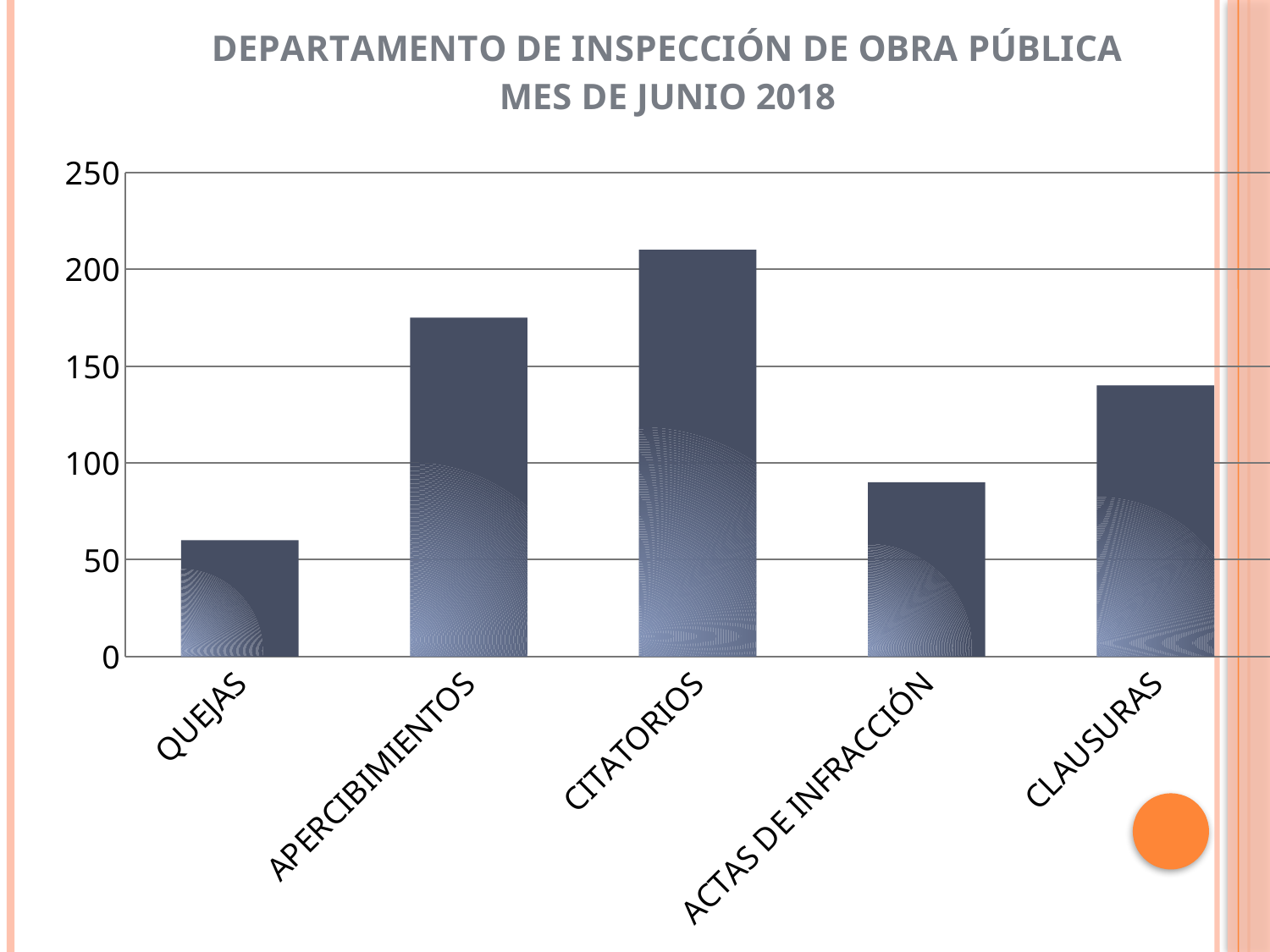
Which is larger, the value for ACTAS DE INFRACCIÓN or the value for QUEJAS? ACTAS DE INFRACCIÓN Which is larger, the value for APERCIBIMIENTOS or the value for CLAUSURAS? APERCIBIMIENTOS Is the value for QUEJAS greater or less than 100? less How many categories are plotted on the chart? 5 Is the value for CITATORIOS greater or less than 200? greater Which category has the highest value? CITATORIOS What is the title of the chart? DEPARTAMENTO DE INSPECCIÓN DE OBRA PÚBLICA MES DE JUNIO 2018 Is the value for CLAUSURAS greater or less than 150? less Which category has the lowest value? QUEJAS What kind of chart is shown on the slide? bar chart